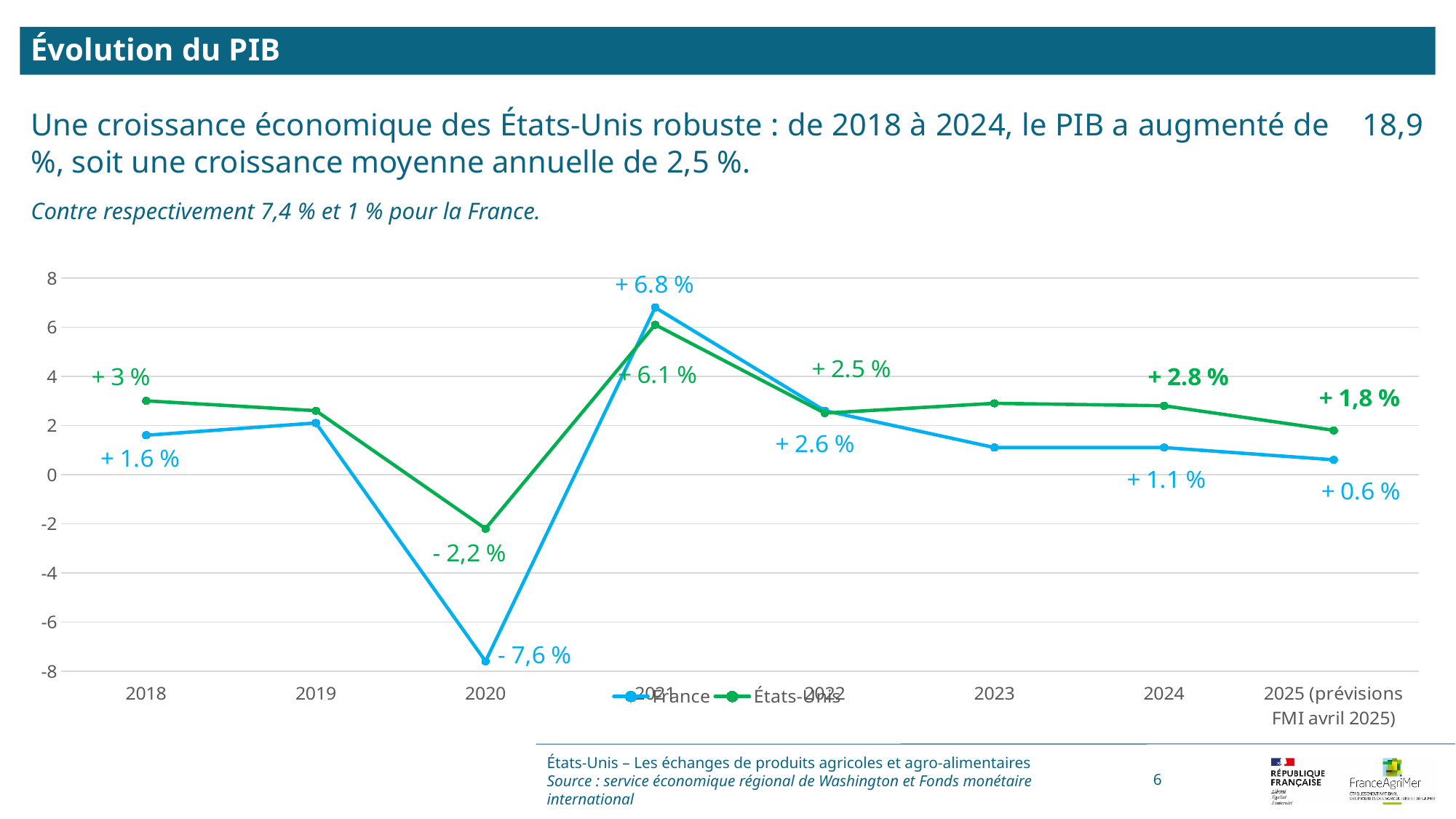
Is the value for États-Unis in 2023 greater or less than 2? greater What is the value for France in 2021? + 6.8 % What is the value for France in 2024? + 1.1 % In which year is the France series at its lowest? 2020 How many years are plotted on the x axis? 8 In which year is the États-Unis series at its highest? 2021 What kind of chart is shown on the slide? Line chart What is the value for États-Unis in 2020? - 2,2 % In 2024, which series has the larger value, France or États-Unis? États-Unis What is the value for États-Unis in 2025 (prévisions FMI avril 2025)? + 1,8 % What is the difference between the France and États-Unis values in 2021? 0.7 % How many series does the legend list? 2